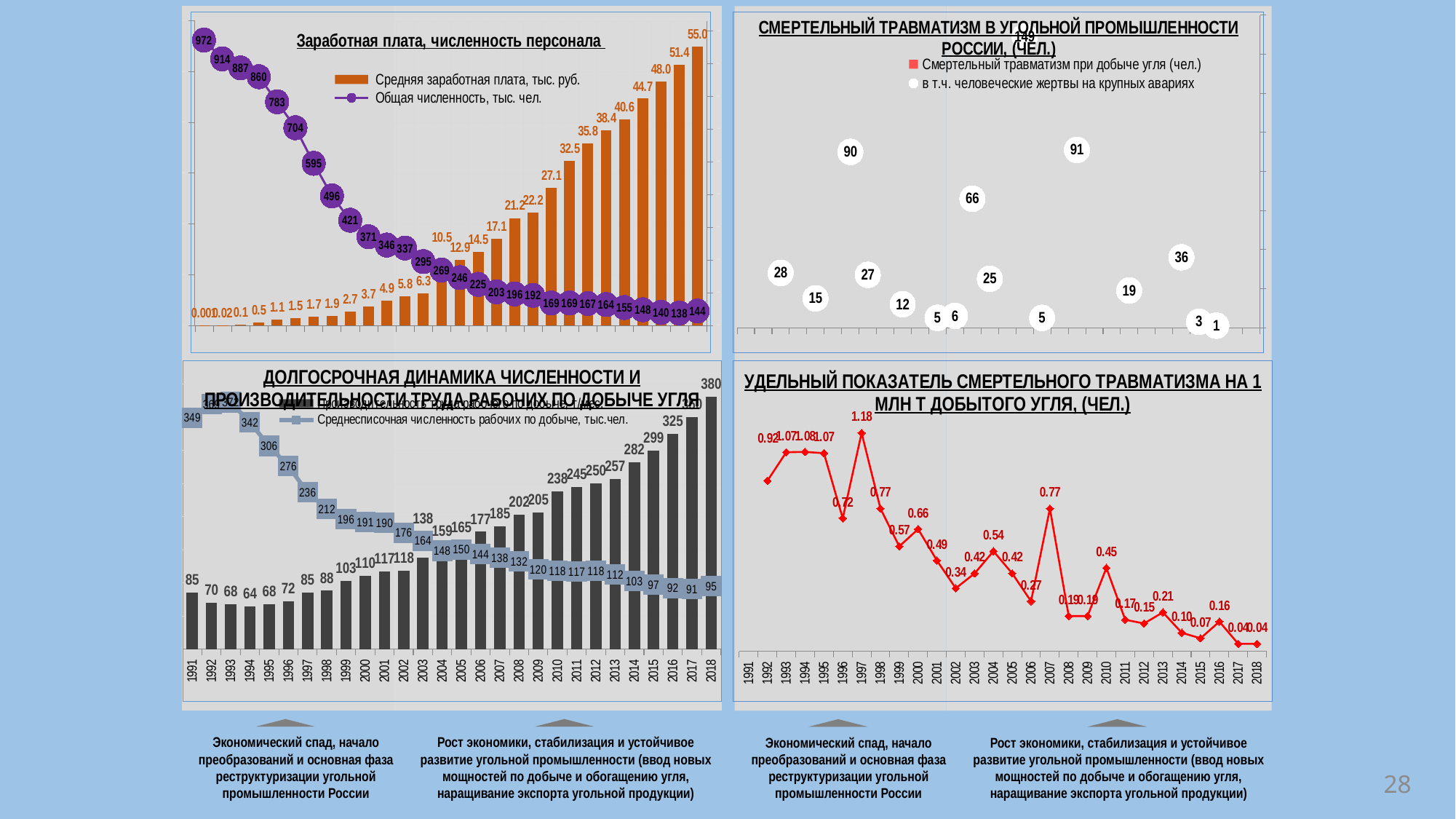
In the bottom-left chart, which bar is taller: 2016 or 2015? 2016 In the top-left chart, what is the leftmost (first) value of the 'Общая численность' line? 972 How many series does the legend of the top-right chart list? 2 In the bottom-left chart, what is the value of the 'Среднесписочная численность рабочих по добыче' line for 1991? 349 In the chart 'Долгосрочная динамика численности и производительности труда рабочих по добыче угля' (bottom left), what is the value of the bar for 2018? 380 In the bottom-left chart, what is the difference between the bar values for 2018 and 2017? 30 In the bottom-left chart, which year has the lowest bar value? 1994 In the chart 'Заработная плата, численность персонала' (top left), what is the highest value of the 'Средняя заработная плата' bars? 55.0 In the bottom-right chart, what is the value for 2007? 0.77 In the chart 'Смертельный травматизм в угольной промышленности России' (top right), what is the highest value shown? 149 In the chart 'Удельный показатель смертельного травматизма на 1 млн т добытого угля' (bottom right), which year has the highest value? 1997 In the bottom-right chart, do the values generally rise or fall from 1992 to 2018? fall